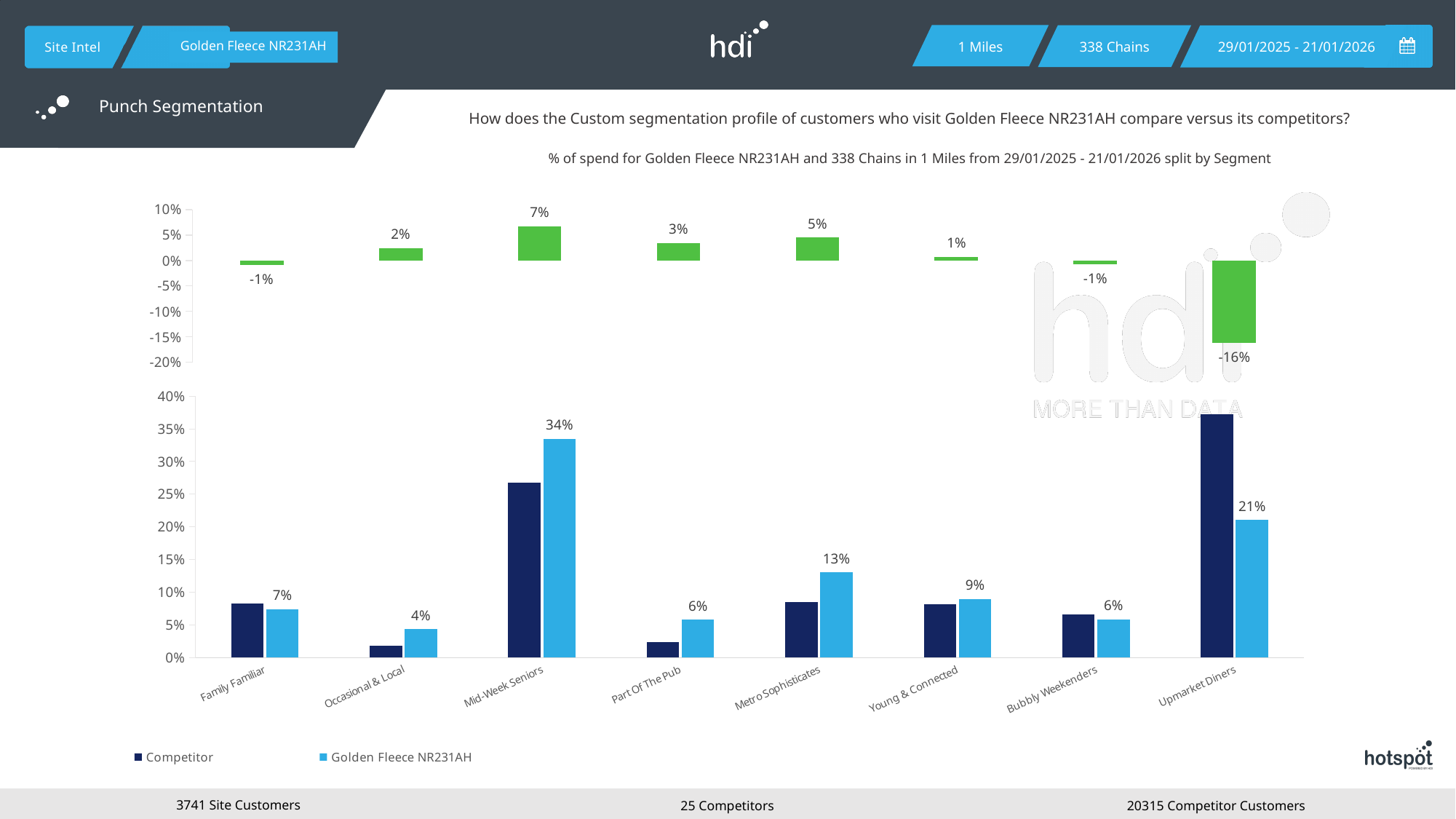
How many series does the legend of the bottom chart list? 2 In the bottom chart, which segment has the highest Golden Fleece NR231AH value? Mid-Week Seniors In the top chart, which segment has the lowest value? Upmarket Diners In the bottom chart, what is the difference between the Golden Fleece NR231AH values for Mid-Week Seniors and Upmarket Diners? 13 percentage points How many segments are shown on the x axis of the bottom chart? 8 In the bottom chart, what is the Golden Fleece NR231AH value for Mid-Week Seniors? 34% In the bottom chart, is the Competitor value for Upmarket Diners greater or less than 30%? greater In the top chart, which segment has the highest value? Mid-Week Seniors In the bottom chart, for Upmarket Diners, which series has the larger value: Competitor or Golden Fleece NR231AH? Competitor In the top chart, what is the value shown for Upmarket Diners? -16% In the bottom chart, what is the Golden Fleece NR231AH value for Metro Sophisticates? 13% What kind of chart is the bottom chart? Bar chart